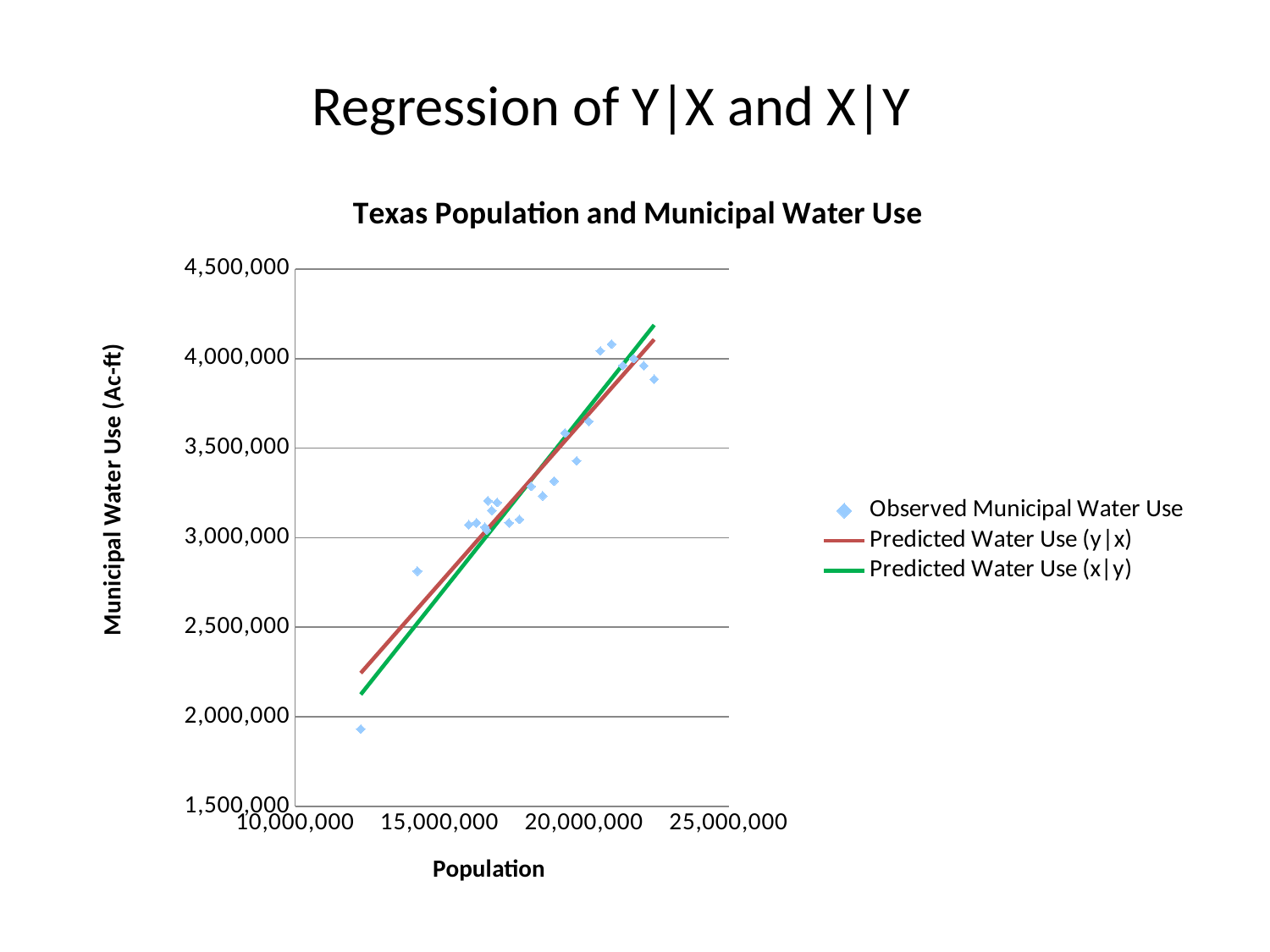
How many series does the chart's legend list? 3 What is the title of the chart? Texas Population and Municipal Water Use Is the observed municipal water use for the lowest-population point (around 12,000,000) greater or less than 2,000,000? less What kind of chart is shown on the slide? Scatter chart Is the observed municipal water use for the point at roughly 14,500,000 population greater or less than 3,000,000? less What is the label of the chart's x axis? Population Which series has the steeper regression line, Predicted Water Use (y|x) or Predicted Water Use (x|y)? Predicted Water Use (x|y) Does municipal water use rise or fall as population increases along the x axis? Rise What is the maximum value shown on the y axis? 4,500,000 Is the observed municipal water use for the highest-population point (around 22,500,000) greater or less than 3,500,000? greater